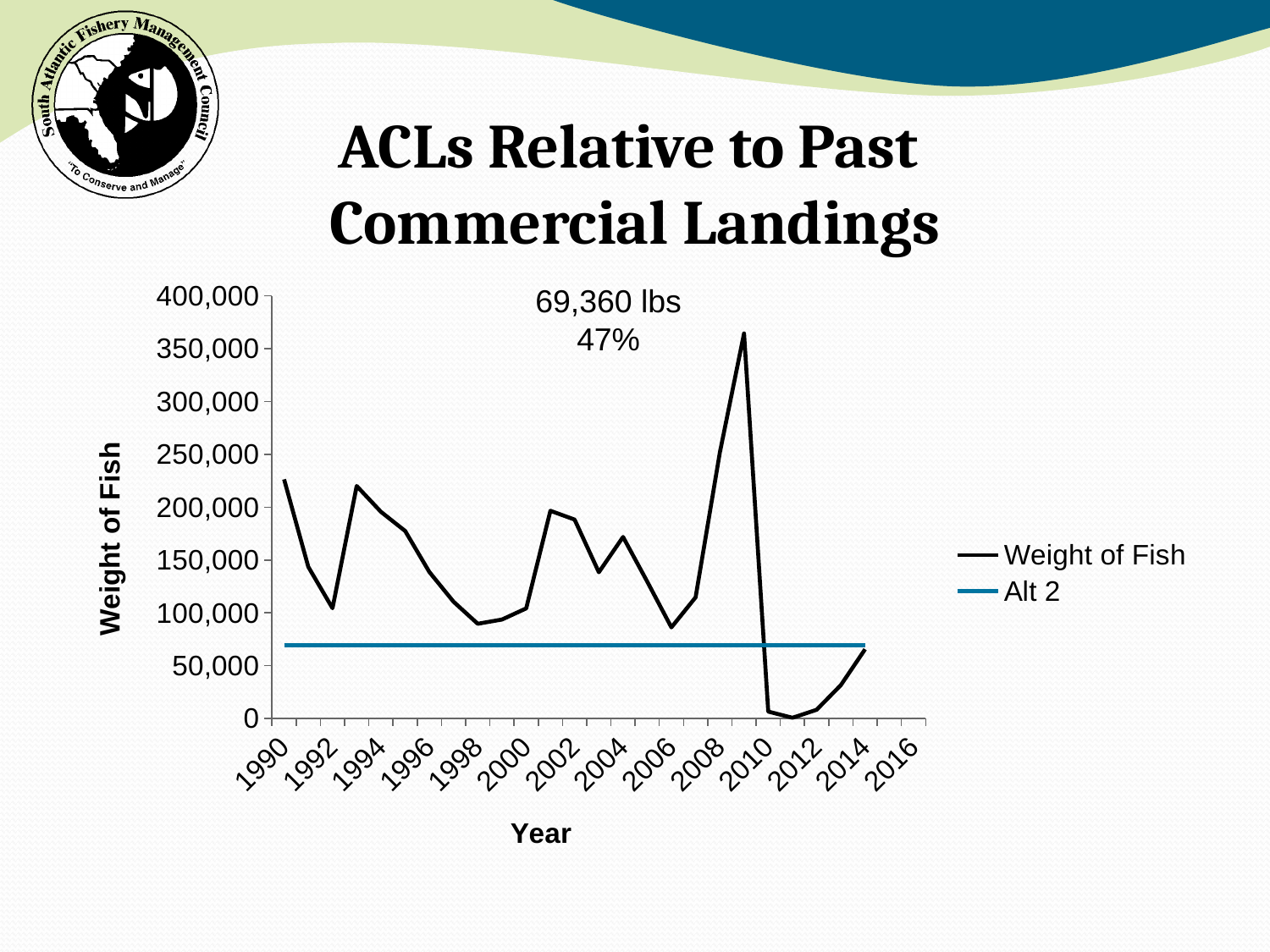
Is the Weight of Fish value for 2009 greater or less than 300,000? greater Does the Weight of Fish series rise or fall between 2009 and 2011? fall Is the Weight of Fish value for 1998 greater or less than 100,000? less In which year does the Weight of Fish series reach its lowest value? 2011 What value and percentage are annotated at the top of the chart? 69,360 lbs, 47% How many series does the legend list? 2 Which year has the larger Weight of Fish value, 1990 or 1992? 1990 Which year has the larger Weight of Fish value, 2001 or 2003? 2001 What is the title of the chart on the slide? ACLs Relative to Past Commercial Landings What kind of chart is shown on the slide? line chart Is the Weight of Fish value for 1990 greater or less than 200,000? greater In which year does the Weight of Fish series reach its highest value? 2009